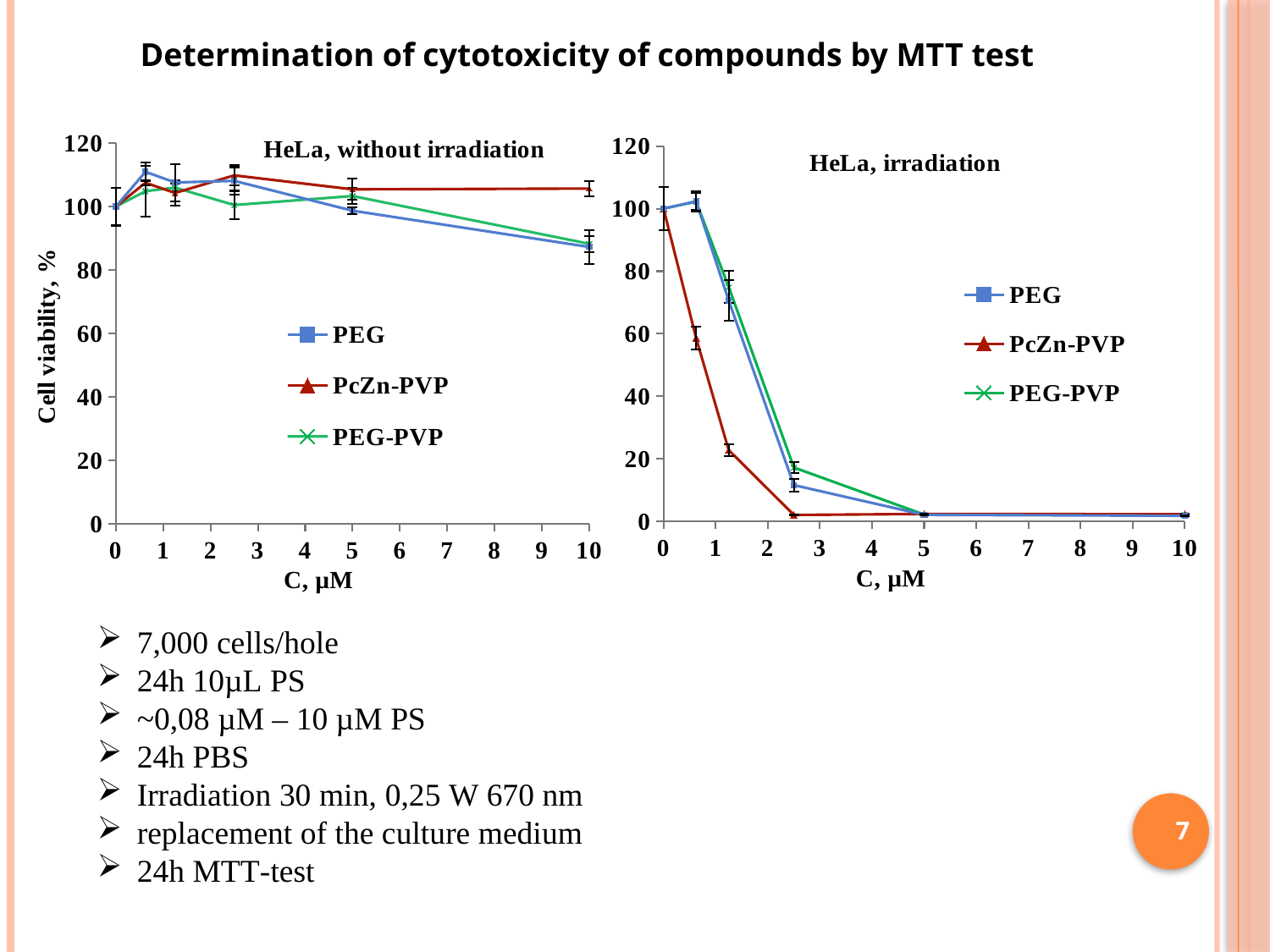
In the 'HeLa, irradiation' chart, is the value for PcZn-PVP at about 1.25 µM greater or less than 40? less In the 'HeLa, without irradiation' chart, is the value for PEG at 10 µM greater or less than 100? less What is the y-axis label of the 'HeLa, without irradiation' chart? Cell viability, % What kind of chart is the 'HeLa, without irradiation' chart? line chart In the 'HeLa, without irradiation' chart, is the value for PcZn-PVP at 10 µM greater or less than 100? greater In the 'HeLa, irradiation' chart, do the values for PcZn-PVP rise or fall as concentration increases along the x axis? fall How many series does the legend of the 'HeLa, irradiation' chart list? 3 In the 'HeLa, without irradiation' chart, which series has the higher value at 10 µM, PcZn-PVP or PEG? PcZn-PVP In the 'HeLa, irradiation' chart, which series has the higher value at about 0.6 µM, PEG or PcZn-PVP? PEG In the 'HeLa, irradiation' chart, which series are listed in the legend? PEG, PcZn-PVP, PEG-PVP